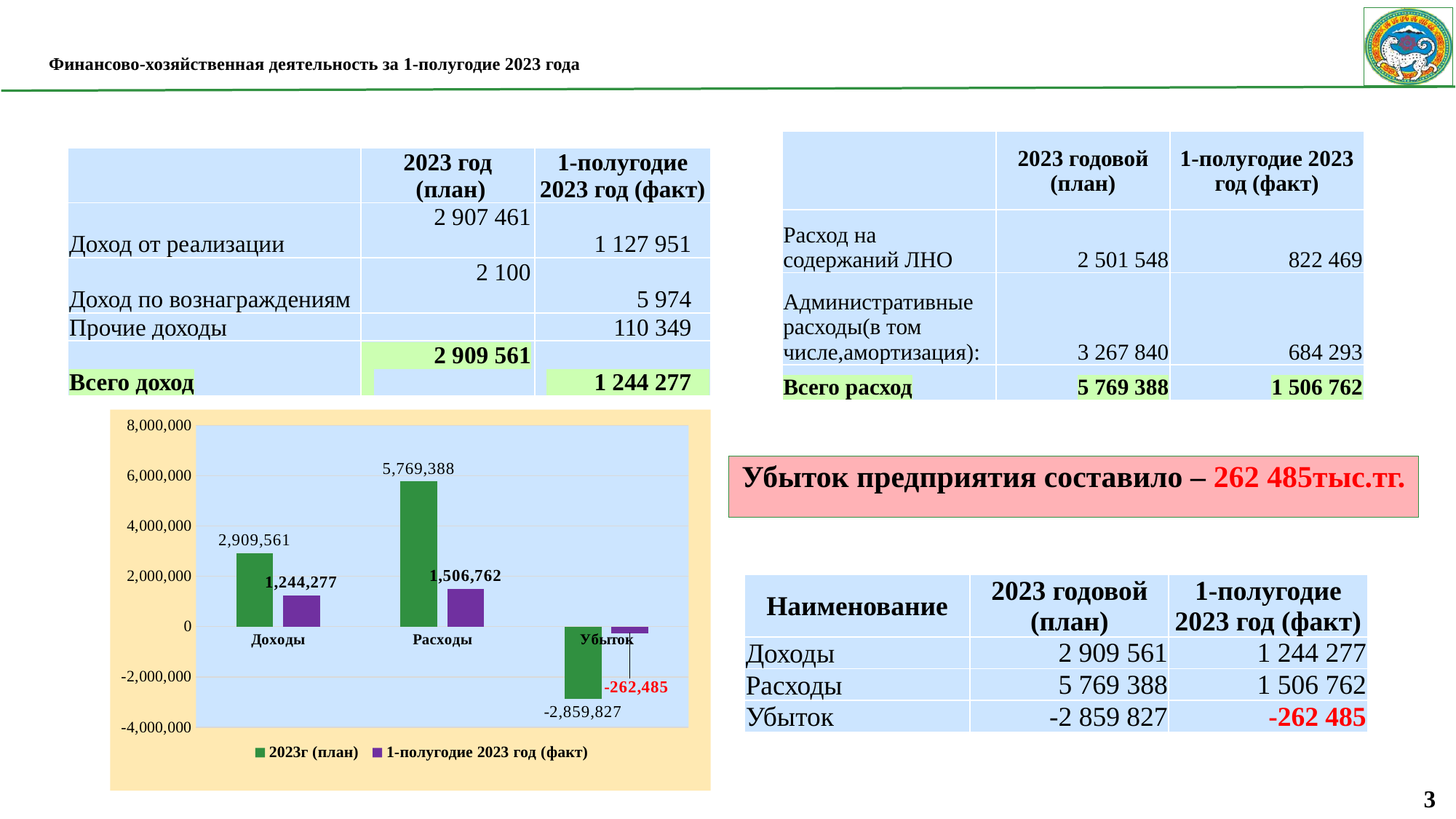
What is the value of the 2023г (план) series for Расходы? 5,769,388 What is the difference between the 2023г (план) values for Расходы and Доходы? 2,859,827 Is the 2023г (план) value for Доходы greater or less than 4,000,000? less Which category has the lowest value in the 1-полугодие 2023 год (факт) series? Убыток Which category has the highest value in the 2023г (план) series? Расходы How many categories are shown on the x axis of the chart? 3 What type of chart is shown on the slide? bar chart What is the value of the 1-полугодие 2023 год (факт) series for Убыток? -262,485 What is the value of the 2023г (план) series for Убыток? -2,859,827 What is the value of the 1-полугодие 2023 год (факт) series for Доходы? 1,244,277 Which is larger: the 1-полугодие 2023 год (факт) value for Расходы or for Доходы? Расходы How many series does the chart legend list? 2